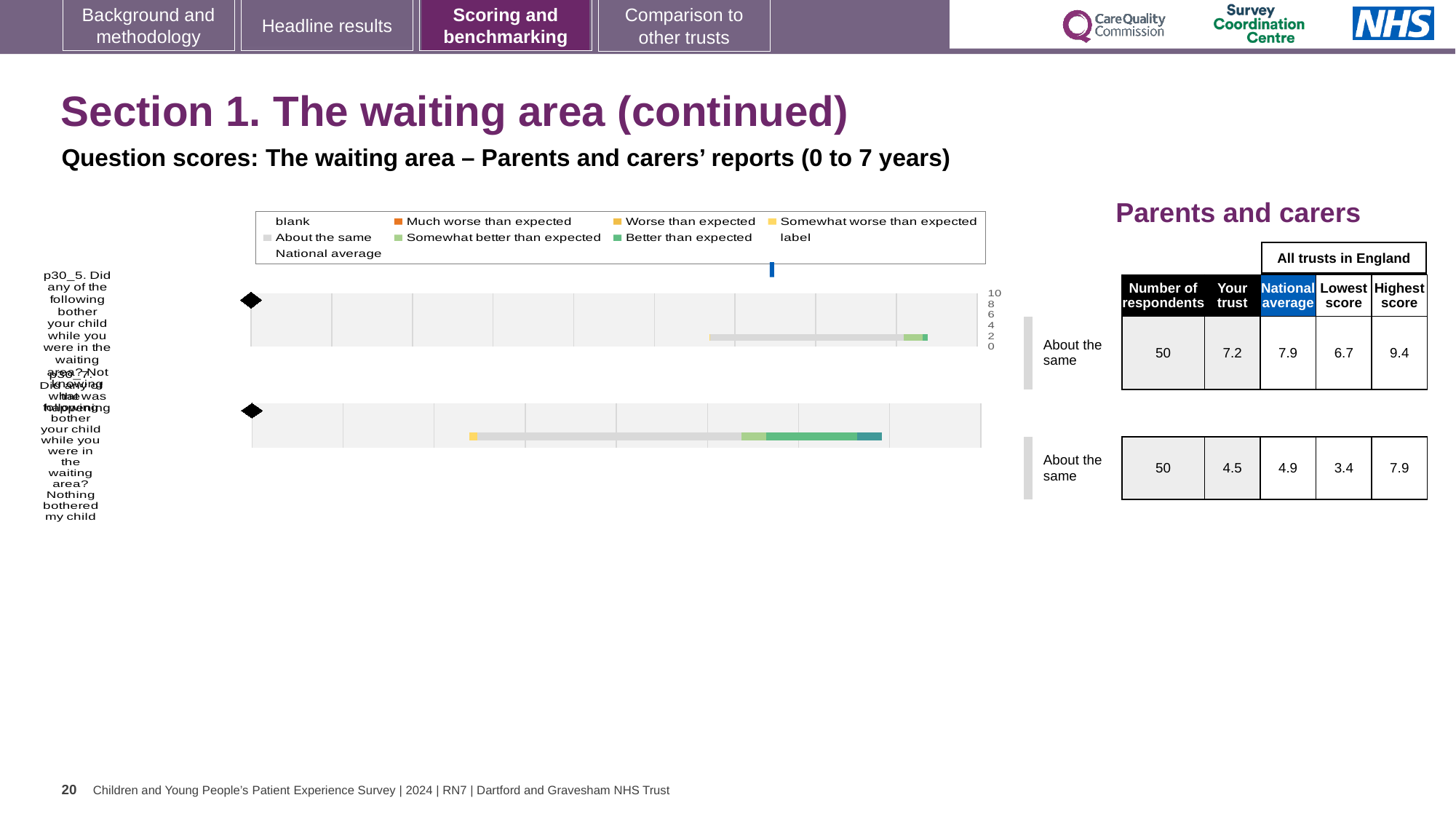
What colour does the legend use for 'Much worse than expected'? orange What is the difference between the national average and the 'Your trust' score for question p30_5? 0.7 Which question has the higher 'Your trust' score, p30_5 or p30_7? p30_5 How many respondents answered question p30_5? 50 What is the difference between the highest score and the lowest score for question p30_7? 4.5 What kind of chart is shown on the slide? bar chart What benchmark category is given for question p30_7? About the same What is the national average score for question p30_7 (Nothing bothered my child)? 4.9 How many survey questions (bars) are plotted in the chart? 2 What is the 'Your trust' score for question p30_5 (Did any of the following bother your child while you were in the waiting area? Not knowing what was happening)? 7.2 What is the highest value shown on the chart's numeric axis? 10 How many entries does the chart legend list? 9